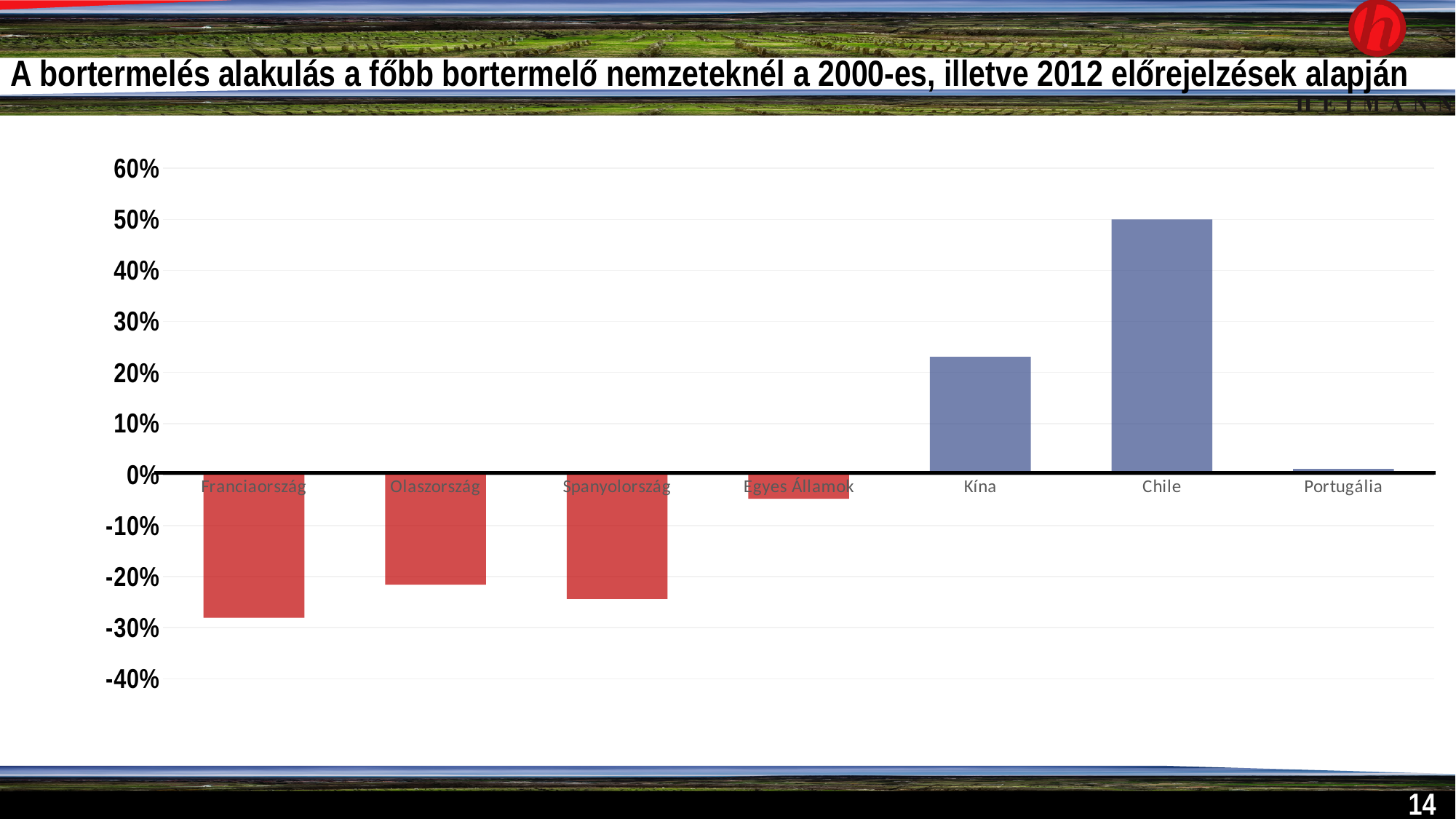
How many countries are shown on the x axis of the chart? 7 Which is larger, the value for Kína or the value for Chile? Chile Is the value for Franciaország greater or less than -20%? less Which country has the highest value in the chart? Chile Which country has the lowest value in the chart? Franciaország Is the value for Kína greater or less than 20%? greater What is the value for Chile? 50% Is the value for Portugália greater or less than 10%? less Which is larger, the value for Egyes Államok or the value for Franciaország? Egyes Államok How many countries have a negative value in the chart? 4 What kind of chart is shown on the slide? bar chart What colour are the bars with negative values? red